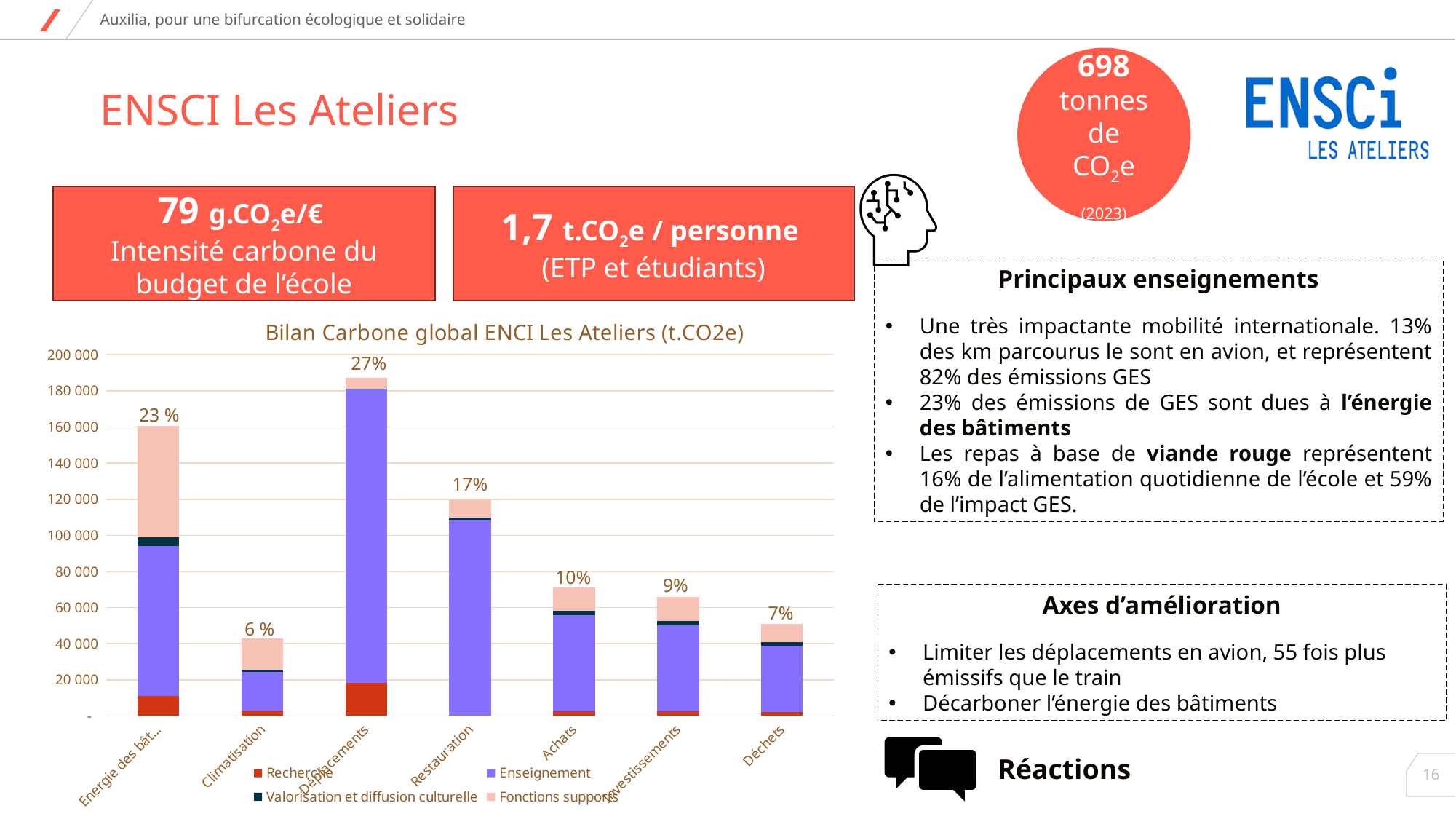
What percentage label is shown above the Déplacements bar? 27% Is the total value for Déchets greater or less than 60 000? less What percentage label is shown above the Climatisation bar? 6 % How many series does the chart legend list? 4 What kind of chart is shown on the slide? Stacked bar chart What is the title of the chart? Bilan Carbone global ENCI Les Ateliers (t.CO2e) Which bar is taller, Achats or Investissements? Achats Is the total value for Déplacements greater or less than 180 000? greater What percentage label is shown above the Restauration bar? 17% Which category has the highest total in the chart? Déplacements How many categories are shown on the x axis of the chart? 7 Which category has the lowest total in the chart? Climatisation